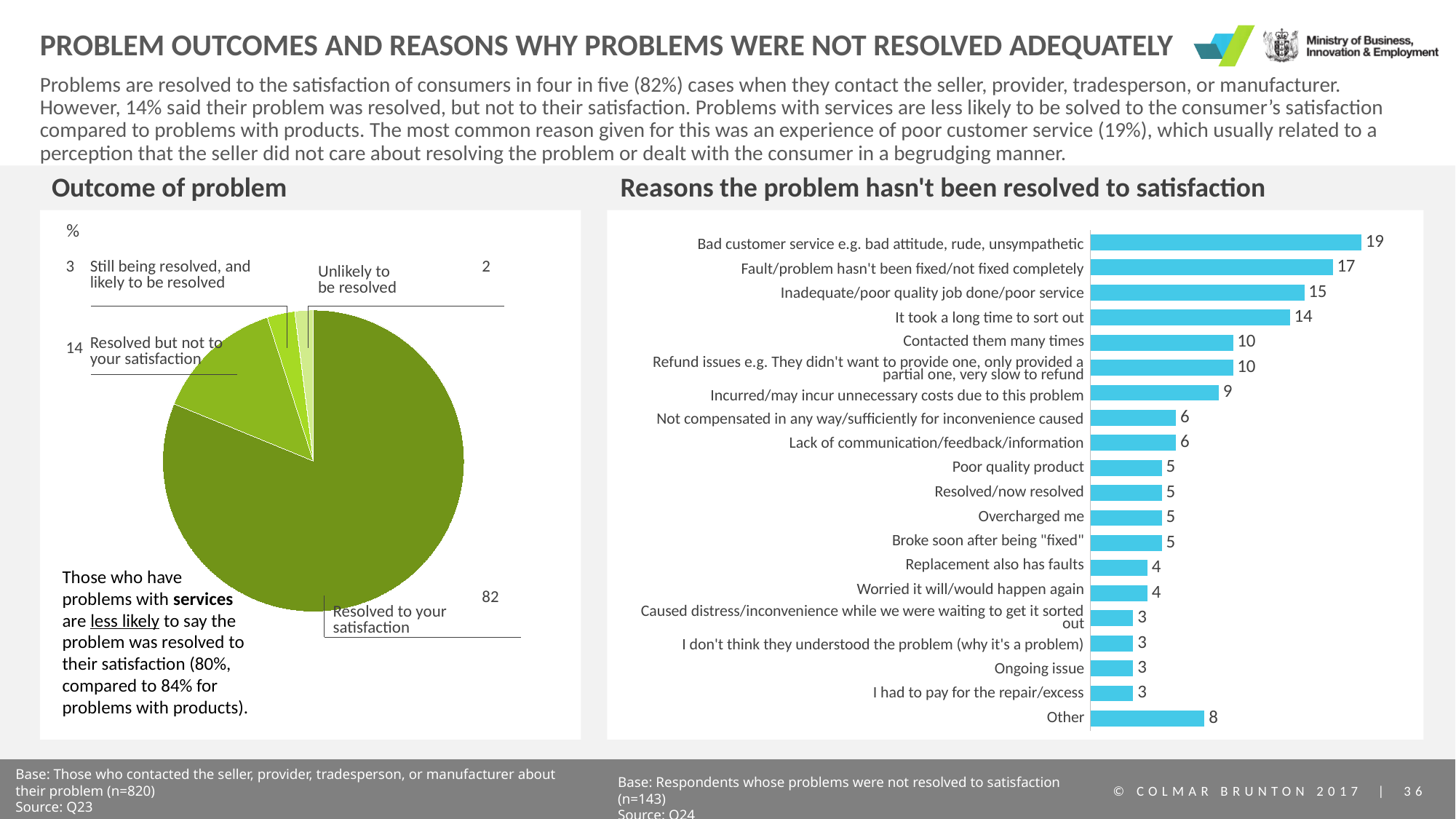
In the 'Reasons the problem hasn't been resolved to satisfaction' chart, which reason has the highest value? Bad customer service e.g. bad attitude, rude, unsympathetic What kind of chart is the 'Outcome of problem' chart? Pie chart In the 'Reasons the problem hasn't been resolved to satisfaction' chart, what is the value for 'It took a long time to sort out'? 14 In the 'Outcome of problem' chart, what value is shown for 'Resolved but not to your satisfaction'? 14 In the 'Reasons the problem hasn't been resolved to satisfaction' chart, what is the difference between 'Bad customer service e.g. bad attitude, rude, unsympathetic' and 'Contacted them many times'? 9 In the 'Outcome of problem' chart, what value is shown for 'Unlikely to be resolved'? 2 In the 'Reasons the problem hasn't been resolved to satisfaction' chart, which is larger: 'Fault/problem hasn't been fixed/not fixed completely' or 'Inadequate/poor quality job done/poor service'? Fault/problem hasn't been fixed/not fixed completely In the 'Reasons the problem hasn't been resolved to satisfaction' chart, what is the value for 'Other'? 8 How many slices does the 'Outcome of problem' pie chart have? 4 What kind of chart is the 'Reasons the problem hasn't been resolved to satisfaction' chart? Bar chart In the 'Outcome of problem' chart, what is the difference between 'Resolved to your satisfaction' and 'Resolved but not to your satisfaction'? 68 In the 'Outcome of problem' chart, what percentage of problems were resolved to your satisfaction? 82